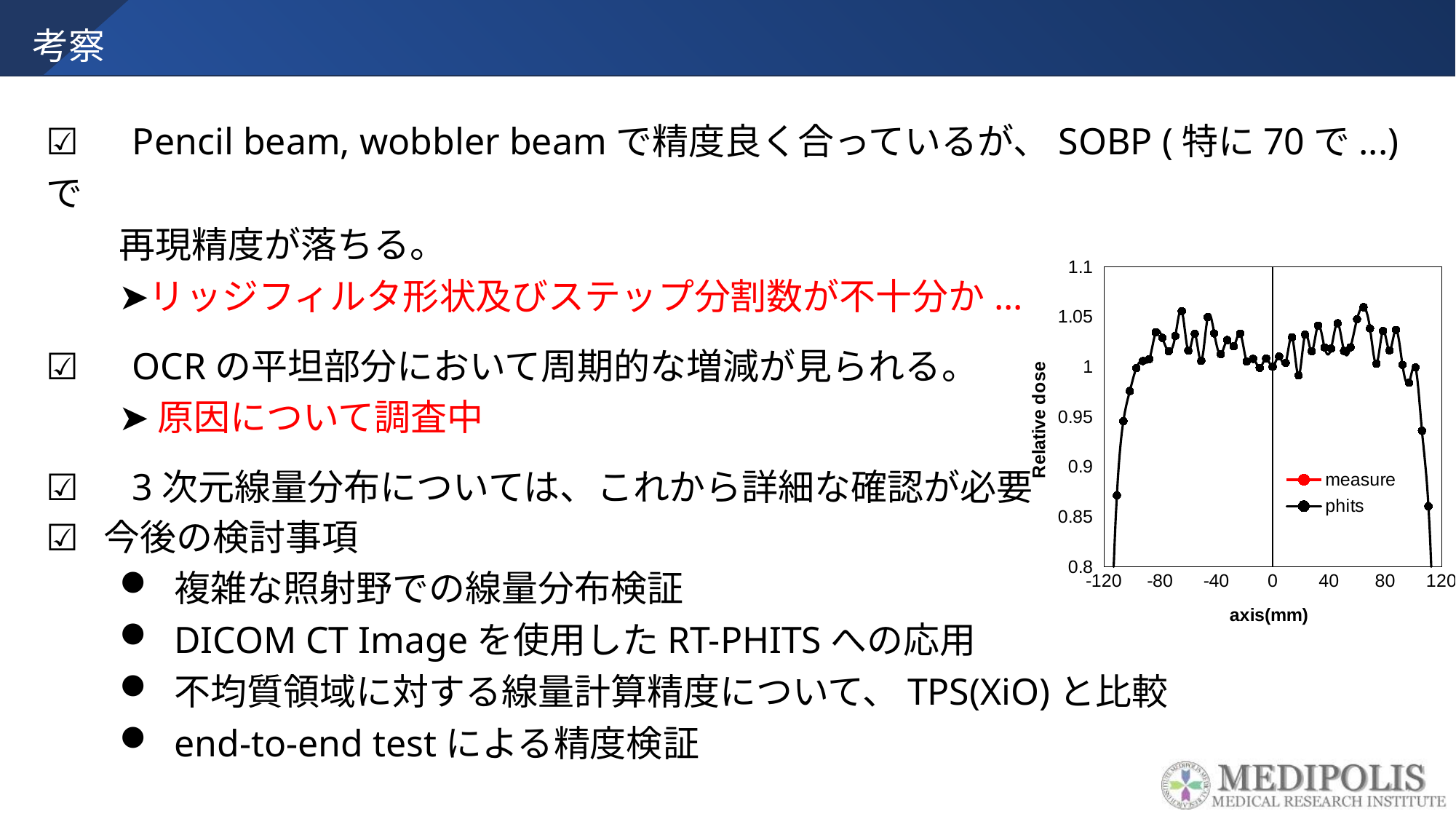
What are the two series named in the chart's legend? measure and phits Is the highest phits value on the chart greater or less than 1.1? less Is the phits value at axis position 0 mm greater or less than 1.05? less Is the phits value at axis position -40 mm greater or less than 0.95? greater Do the phits values rise or fall as the axis position goes from -120 mm to -80 mm? rise What is the label of the chart's y axis? Relative dose How many series does the chart's legend list? 2 What kind of chart is shown on the slide? line chart Do the phits values rise or fall as the axis position goes from 80 mm to 120 mm? fall